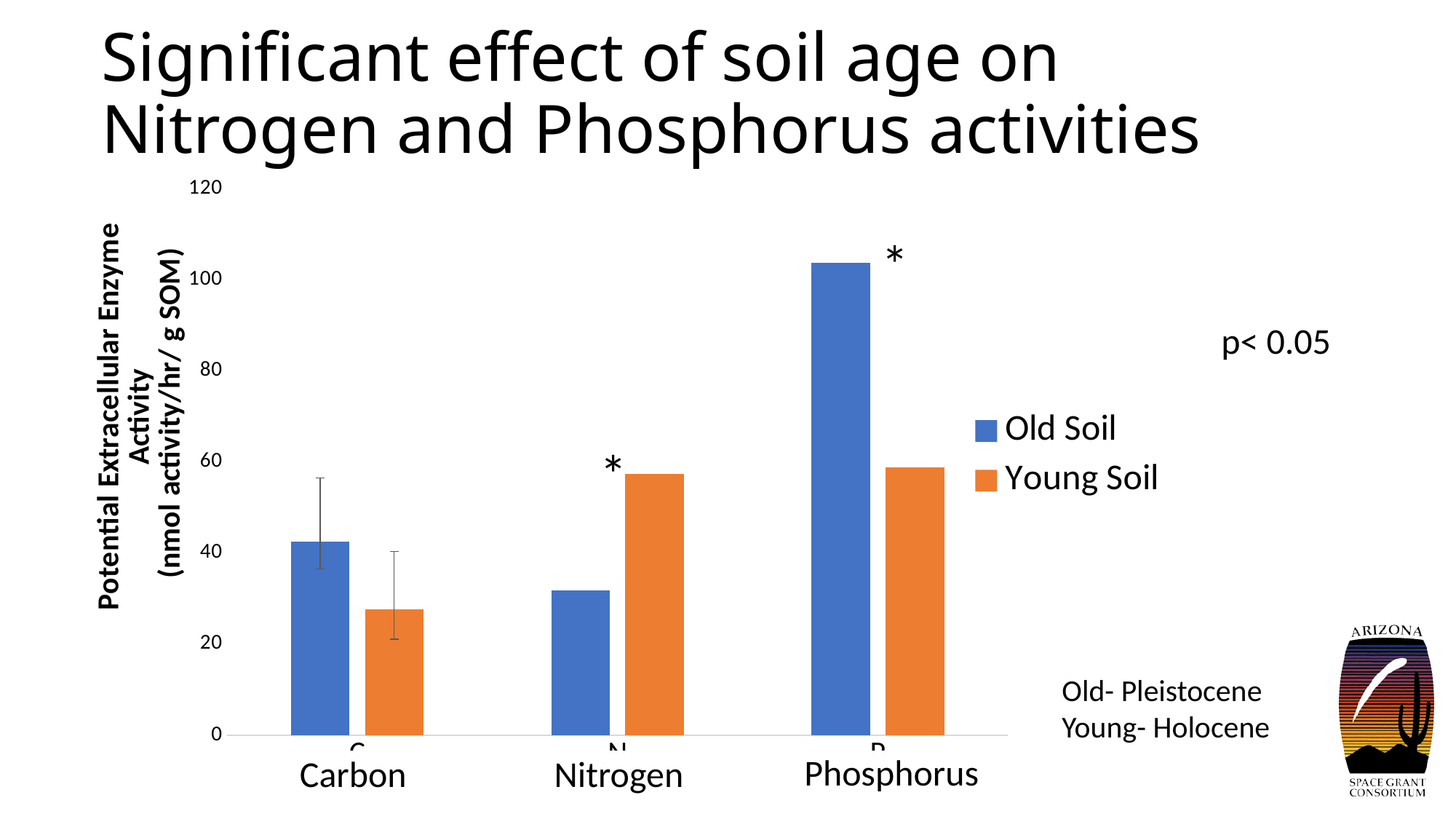
How many categories are shown on the x axis? 3 For which category is the Old Soil value lowest? Nitrogen Is the Old Soil value for Phosphorus greater or less than 80? greater Is the Old Soil value for Nitrogen greater or less than 40? less For which category is the Young Soil value lowest? Carbon Is the Young Soil value for Phosphorus greater or less than 80? less For Carbon, which is larger: Old Soil or Young Soil? Old Soil What are the two entries in the chart legend? Old Soil and Young Soil How many series does the legend list? 2 For which category is the Old Soil value highest? Phosphorus What kind of chart is shown on the slide? bar chart For Nitrogen, which is larger: Old Soil or Young Soil? Young Soil